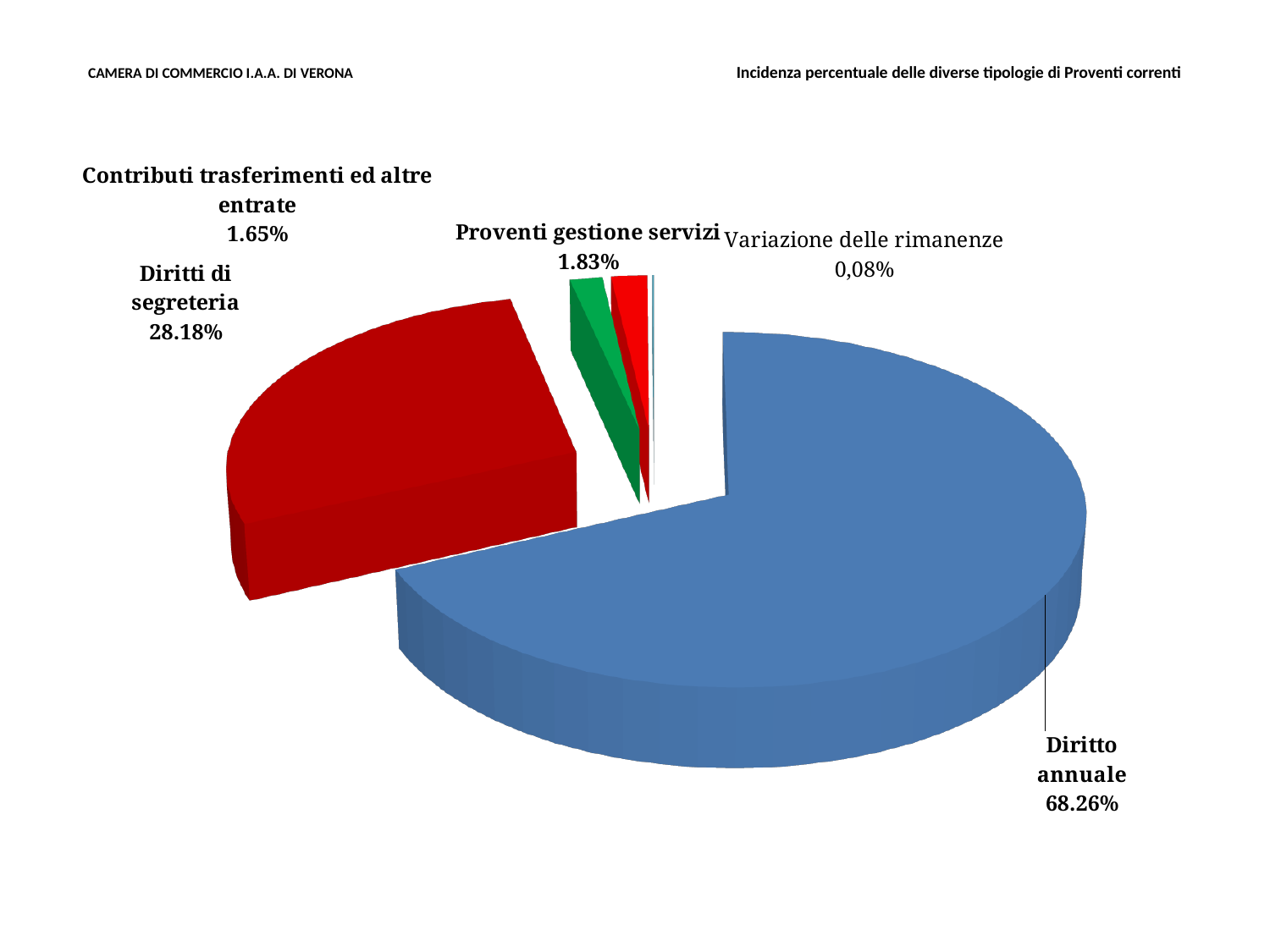
What percentage is shown for Diritti di segreteria? 28.18% What percentage is shown for Diritto annuale? 68.26% What kind of chart is shown on the slide? Pie chart Which category has the smallest slice of the pie? Variazione delle rimanenze What percentage is shown for Contributi trasferimenti ed altre entrate? 1.65% What is the title of the chart? Incidenza percentuale delle diverse tipologie di Proventi correnti How many slices does the pie chart have? 5 Which category has the largest slice of the pie? Diritto annuale What percentage is shown for Variazione delle rimanenze? 0,08% What is the difference in percentage points between Diritto annuale and Diritti di segreteria? 40.08 Which is larger, Proventi gestione servizi or Contributi trasferimenti ed altre entrate? Proventi gestione servizi What percentage is shown for Proventi gestione servizi? 1.83%